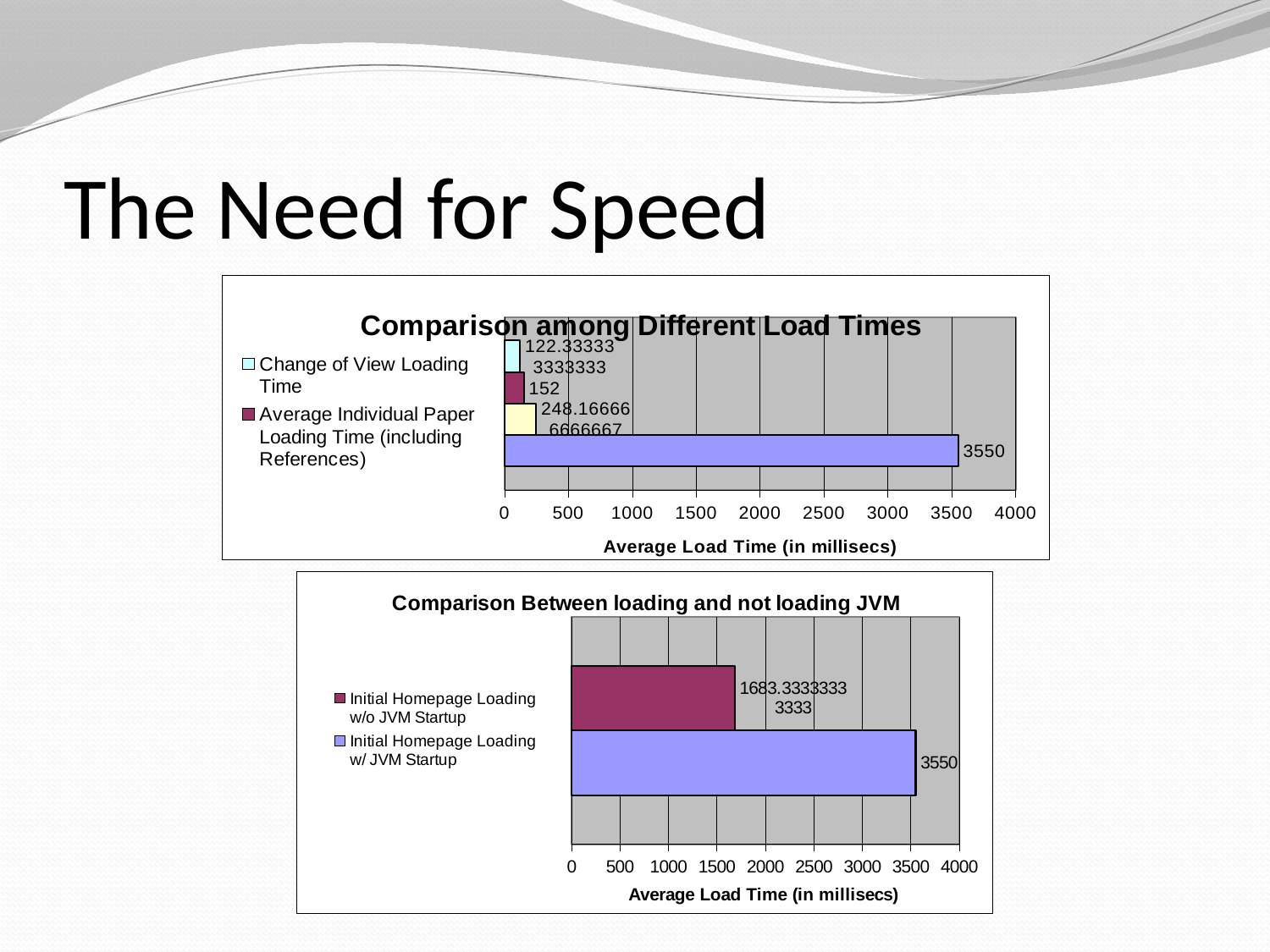
In the top chart, 'Comparison among Different Load Times', what is the value for Average Individual Paper Loading Time (including References)? 152 How many series does the legend of the bottom chart, 'Comparison Between loading and not loading JVM', list? 2 In the top chart, 'Comparison among Different Load Times', what is the largest value printed as a data label? 3550 In the top chart, 'Comparison among Different Load Times', is the value for Change of View Loading Time greater or less than 500? less In the top chart, 'Comparison among Different Load Times', how many bars are plotted? 4 In the top chart, 'Comparison among Different Load Times', which is larger: Change of View Loading Time or Average Individual Paper Loading Time (including References)? Average Individual Paper Loading Time (including References) What kind of chart is the bottom chart, 'Comparison Between loading and not loading JVM'? bar chart What kind of chart is the top chart, 'Comparison among Different Load Times'? bar chart In the bottom chart, 'Comparison Between loading and not loading JVM', is the value for Initial Homepage Loading w/o JVM Startup greater or less than 1500? greater In the bottom chart, 'Comparison Between loading and not loading JVM', what is the value for Initial Homepage Loading w/ JVM Startup? 3550 What is the x-axis title of the top chart, 'Comparison among Different Load Times'? Average Load Time (in millisecs) In the bottom chart, 'Comparison Between loading and not loading JVM', which is larger: Initial Homepage Loading w/o JVM Startup or Initial Homepage Loading w/ JVM Startup? Initial Homepage Loading w/ JVM Startup